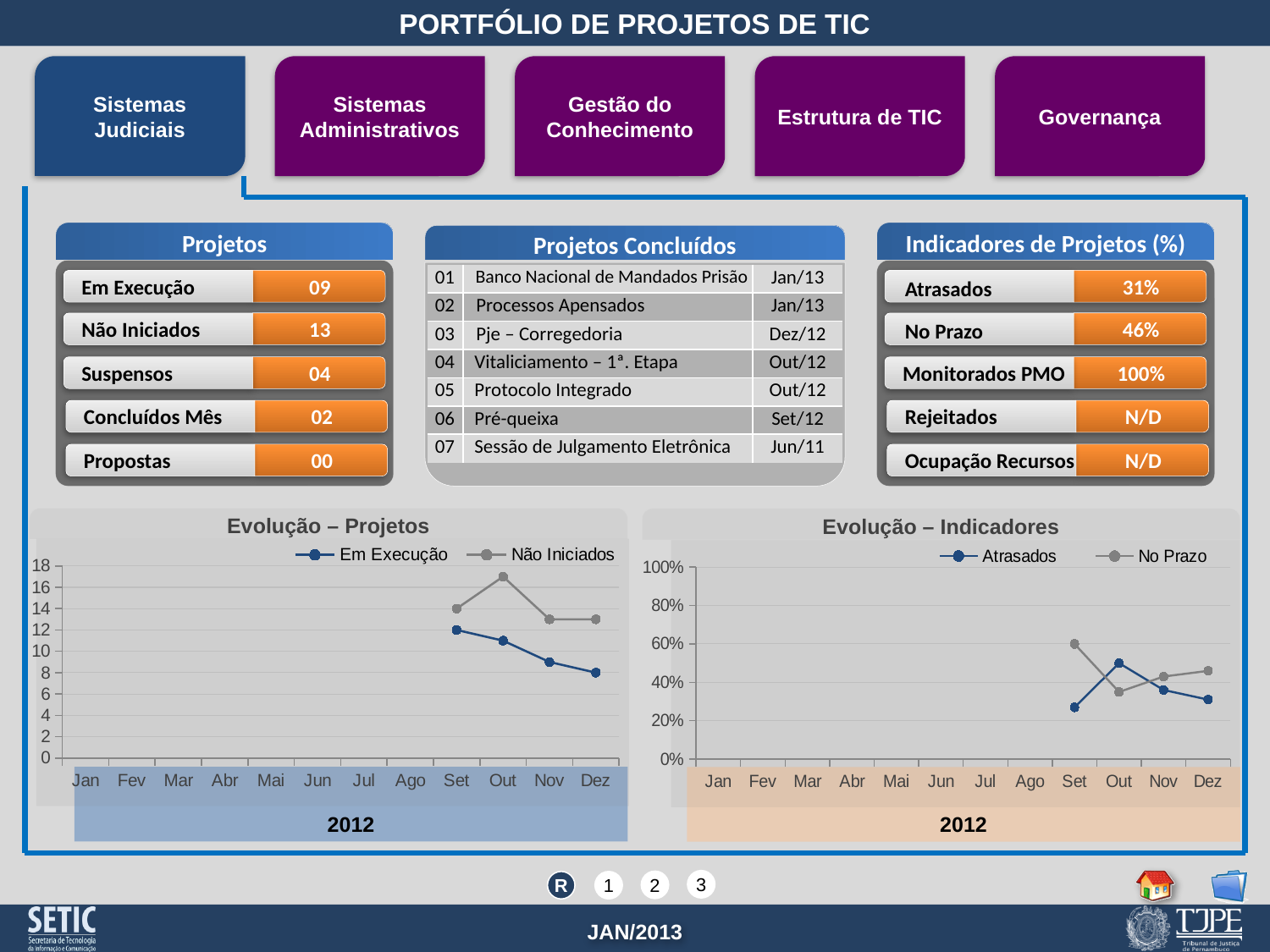
In the 'Evolução – Indicadores' chart, which series has the larger value in Set, 'Atrasados' or 'No Prazo'? No Prazo In the 'Evolução – Projetos' chart, does the 'Em Execução' series rise or fall from Set to Dez? fall In the 'Evolução – Projetos' chart, is the value for 'Não Iniciados' in Out greater or less than 14? greater In the 'Evolução – Indicadores' chart, how many months have plotted data points? 4 How many series does the legend of the 'Evolução – Projetos' chart list? 2 What kind of chart is the 'Evolução – Projetos' chart? line chart In the 'Evolução – Projetos' chart, in which month is the 'Em Execução' series lowest? Dez In the 'Evolução – Projetos' chart, what are the two series named in the legend? Em Execução and Não Iniciados In the 'Evolução – Projetos' chart, which series has the larger value in Set, 'Em Execução' or 'Não Iniciados'? Não Iniciados How many series does the legend of the 'Evolução – Indicadores' chart list? 2 In the 'Evolução – Indicadores' chart, is the value for 'Atrasados' in Set greater or less than 40%? less In the 'Evolução – Projetos' chart, in which month is the 'Não Iniciados' series highest? Out